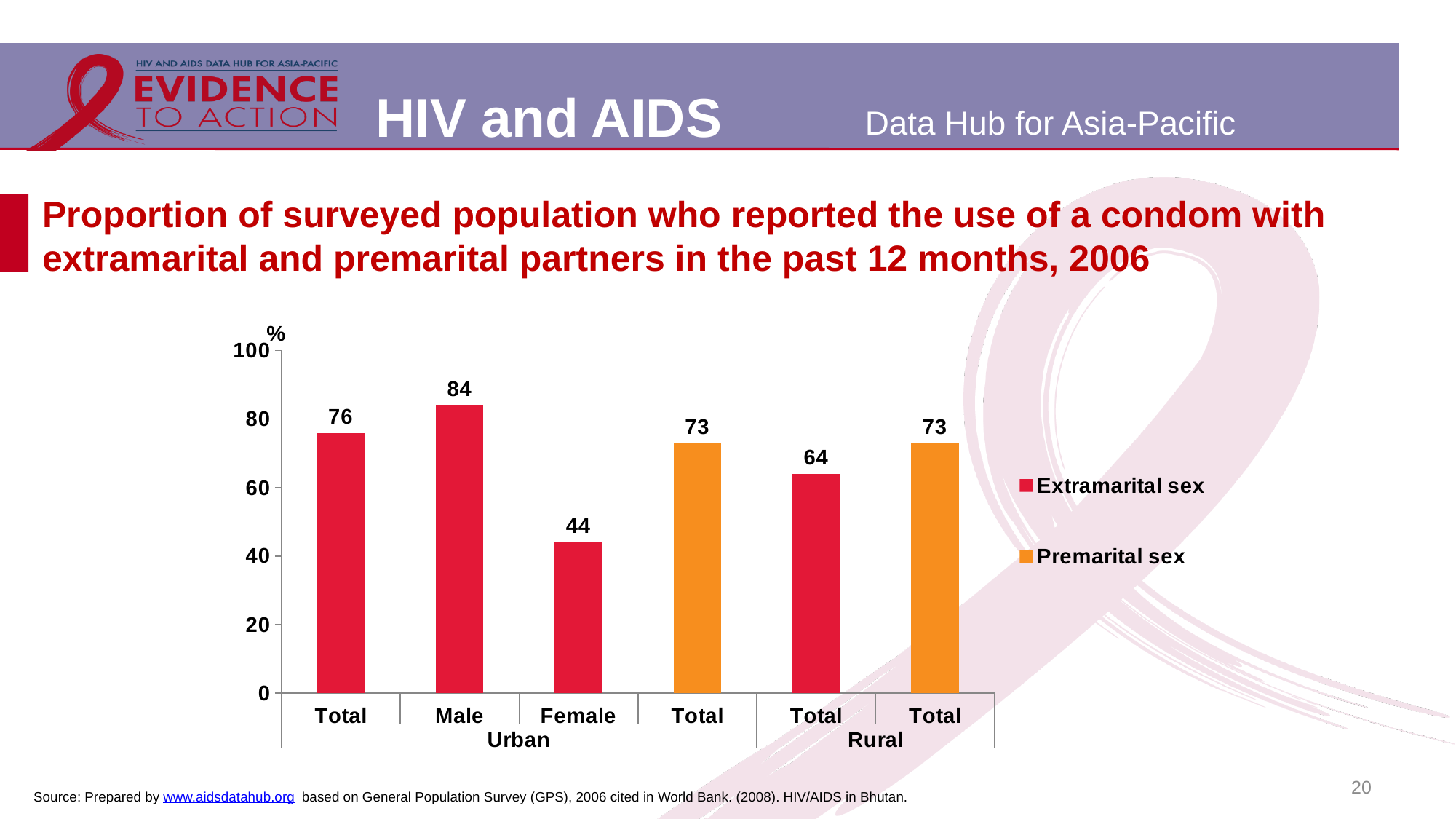
What is the value for Urban Total for Premarital sex? 73 What is the value for Rural Total for Extramarital sex? 64 What colour represents Premarital sex in the chart? Orange What is the value for Urban Female (Extramarital sex)? 44 What kind of chart is shown on the slide? Bar chart How many bars are plotted in the chart? 6 What is the value for Urban Male (Extramarital sex)? 84 How many series does the legend list? 2 What is the difference between the Urban Male and Urban Female values for Extramarital sex? 40 Which is larger: the Urban Total for Extramarital sex or the Rural Total for Extramarital sex? Urban Total for Extramarital sex Which bar has the lowest value? Urban Female (Extramarital sex) Which bar has the highest value? Urban Male (Extramarital sex)